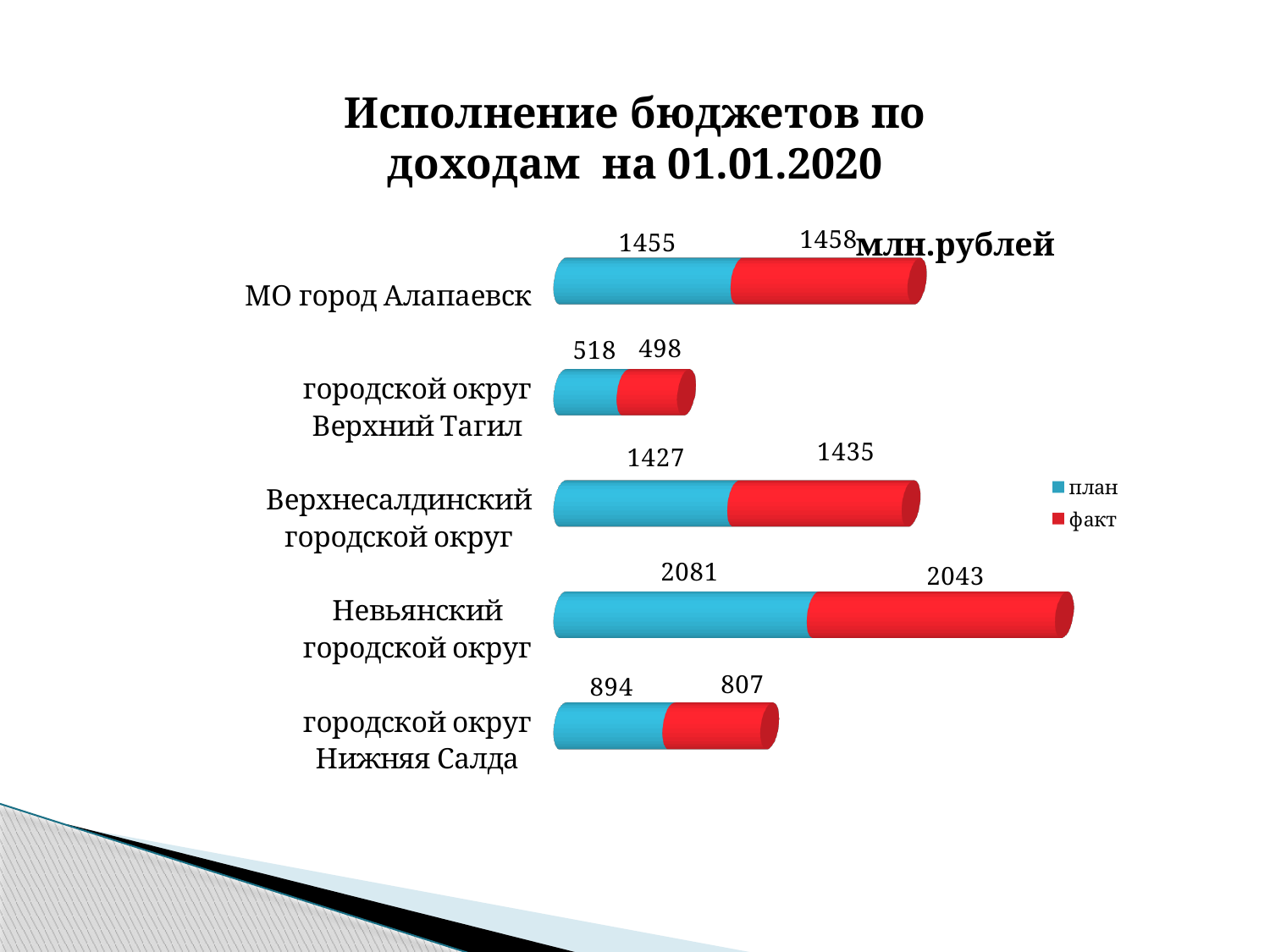
What is the план value for Невьянский городской округ? 2081 What is the факт value for городской округ Верхний Тагил? 498 Which category has the highest план value? Невьянский городской округ Which category has the lowest факт value? городской округ Верхний Тагил How many series does the legend list? 2 What type of chart is shown on the slide? bar chart Which is larger for Верхнесалдинский городской округ, план or факт? факт What is the план value for городской округ Нижняя Салда? 894 What is the difference between the план and факт values for Невьянский городской округ? 38 How many categories are shown in the chart? 5 What is the difference between the план and факт values for городской округ Нижняя Салда? 87 What is the факт value for МО город Алапаевск? 1458